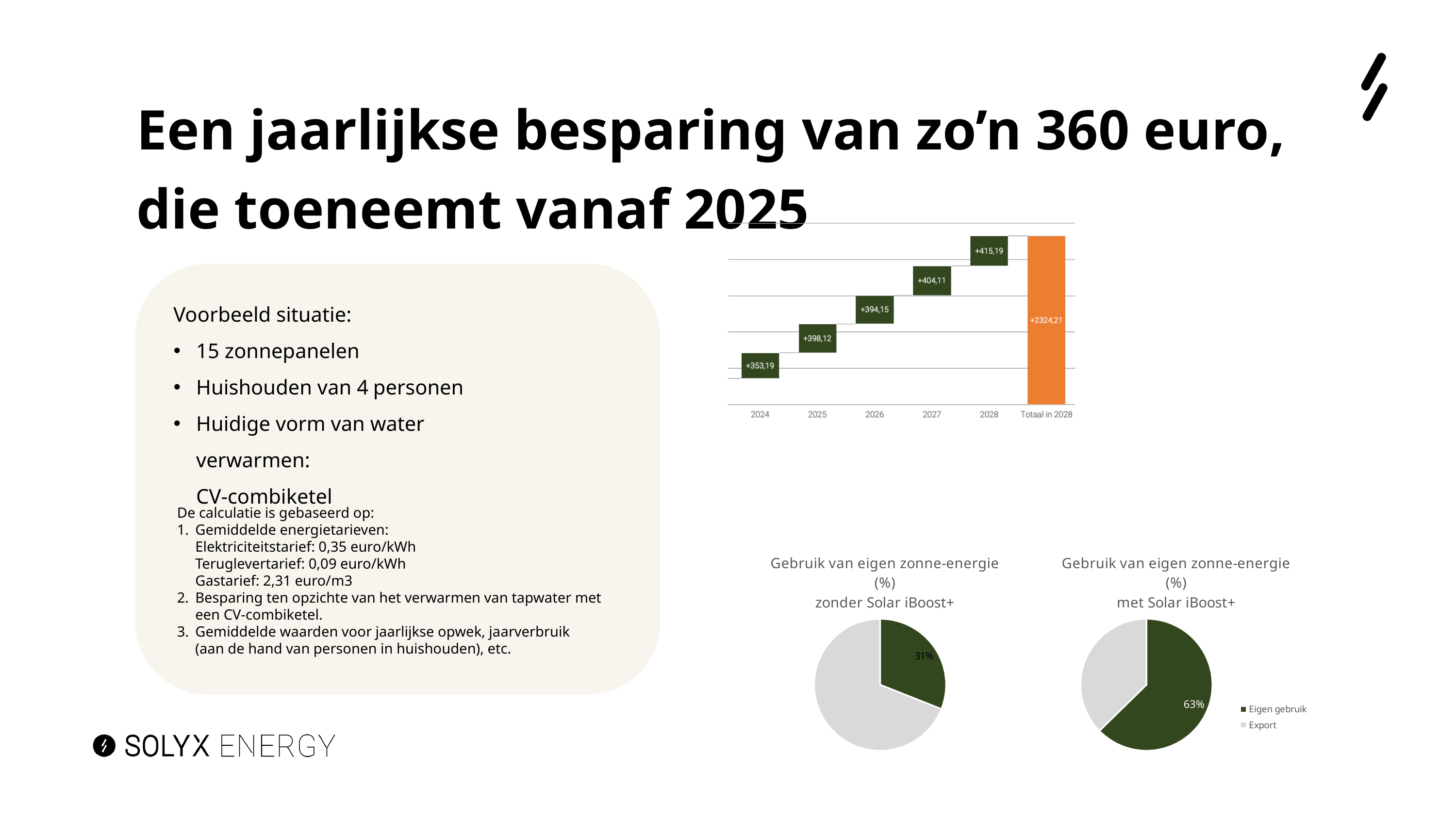
How many bars are shown in the top-right waterfall chart, including the total bar? 6 In the pie chart 'Gebruik van eigen zonne-energie (%) zonder Solar iBoost+', what share is Eigen gebruik? 31% What kind of chart is the top-right chart showing the yearly savings? Bar chart (waterfall) In the pie chart 'Gebruik van eigen zonne-energie (%) met Solar iBoost+', what share is Eigen gebruik? 63% In the top-right waterfall chart, which is larger: the value for 2025 or the value for 2026? 2025 In the top-right waterfall chart, which year from 2024 to 2028 has the highest annual value? 2028 In the top-right waterfall chart, what is the value of the 'Totaal in 2028' bar? +2324,21 How many entries does the legend of the pie charts list? 2 In the top-right waterfall chart, what is the value shown for 2024? +353,19 In the top-right waterfall chart, what is the difference between the 2028 value and the 2024 value? 62,00 In the top-right waterfall chart, which year from 2024 to 2028 has the lowest annual value? 2024 In the top-right waterfall chart, what is the value shown for 2027? +404,11